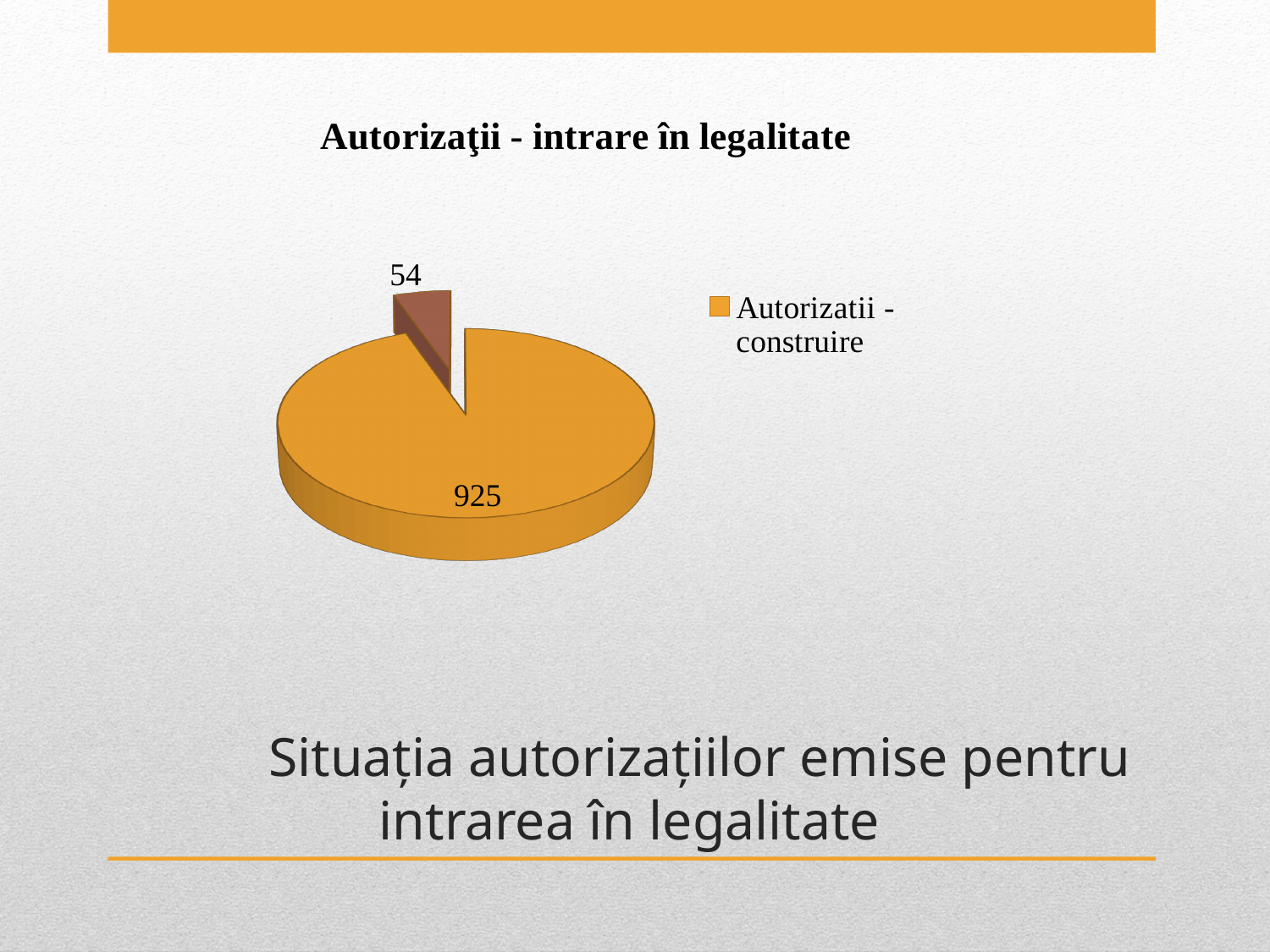
What is the title of the chart? Autorizaţii - intrare în legalitate Which slice of the pie is the largest? Autorizatii - construire What is the value of the smallest slice in the pie chart? 54 How many slices does the pie chart have? 2 What kind of chart is shown on the slide? pie chart What value is shown for the 'Autorizatii - construire' slice? 925 How many entries does the chart legend list? 1 Is the 'Autorizatii - construire' slice larger or smaller than the brown slice? larger What is the total of the two values shown in the pie chart? 979 What is the difference between the two slice values, 925 and 54? 871 What value is printed on the smaller brown slice of the pie? 54 What colour is the 'Autorizatii - construire' slice? orange